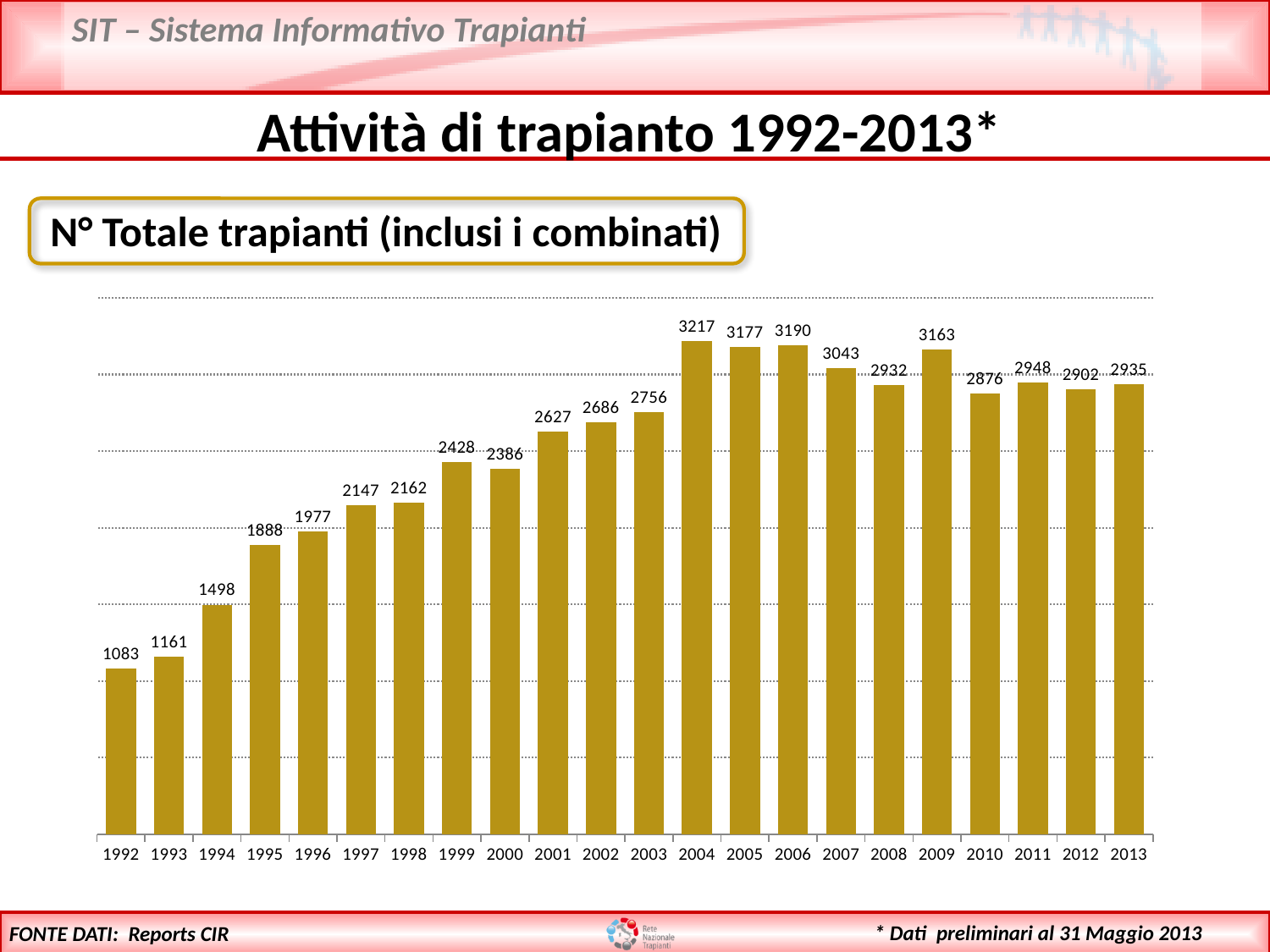
What is the difference between the values for 2013 and 2012? 33 What is the value shown for 2013? 2935 What is the value shown for 2004? 3217 What is the value shown for 1992? 1083 Which year has the highest value? 2004 Which is larger, the value for 2005 or the value for 2006? 2006 What is the value shown for 2000? 2386 What kind of chart is shown on the slide? Bar chart What is the difference between the values for 2004 and 1992? 2134 Which year has the lowest value? 1992 How many years are shown on the x axis? 22 Do the values rise or fall from 1992 to 2004? Rise